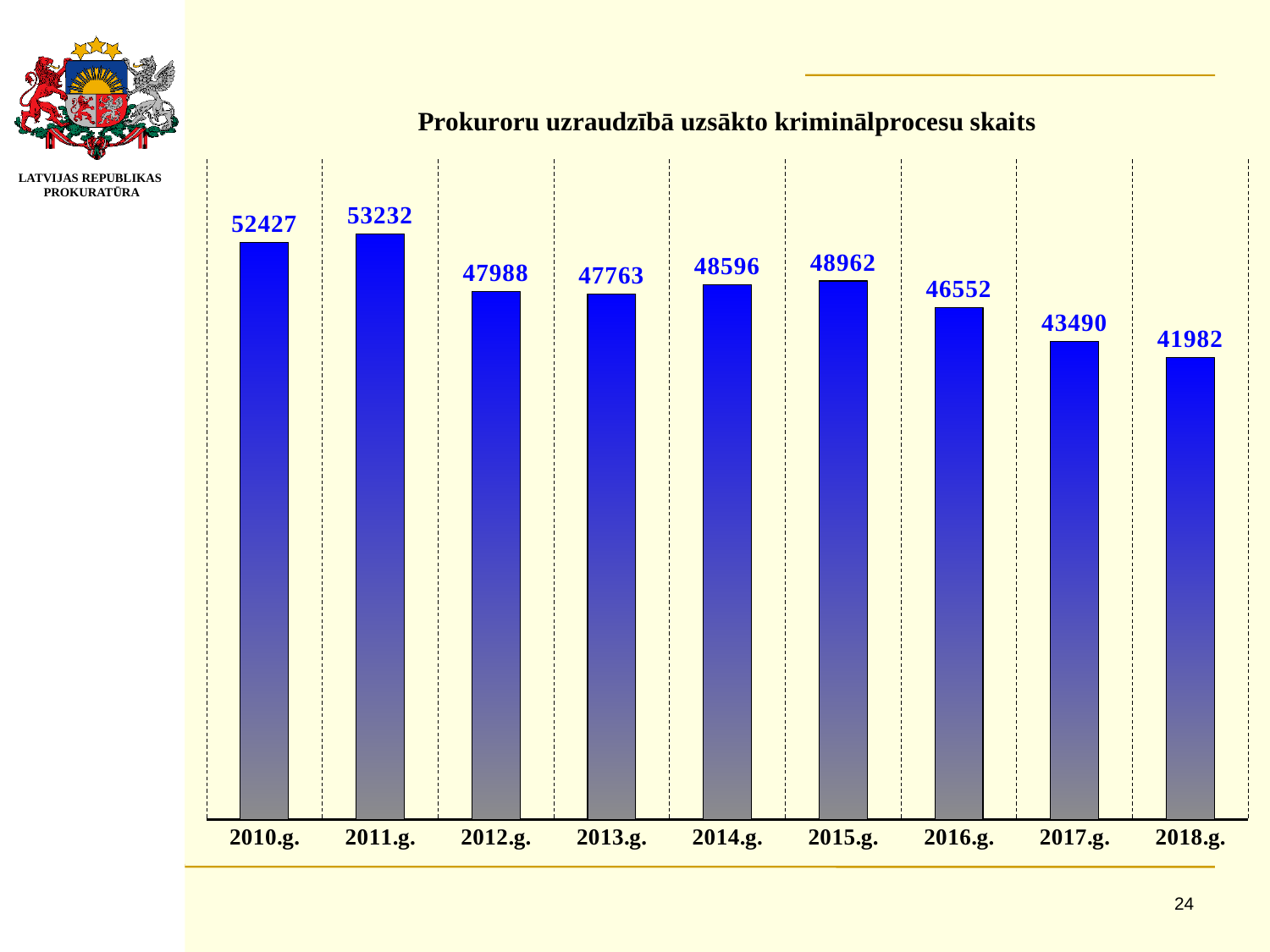
What is the difference between the values for 2017.g. and 2018.g.? 1508 Do the values rise or fall from 2015.g. to 2018.g.? fall Which year has the highest value? 2011.g. Which is larger, the value for 2014.g. or the value for 2015.g.? 2015.g. What is the value for 2018.g.? 41982 What is the difference between the values for 2011.g. and 2010.g.? 805 Which year has the lowest value? 2018.g. How many years are shown on the x axis? 9 What is the value for 2016.g.? 46552 What is the title of the chart? Prokuroru uzraudzībā uzsākto kriminālprocesu skaits What is the value for 2010.g.? 52427 What kind of chart is shown on the slide? bar chart